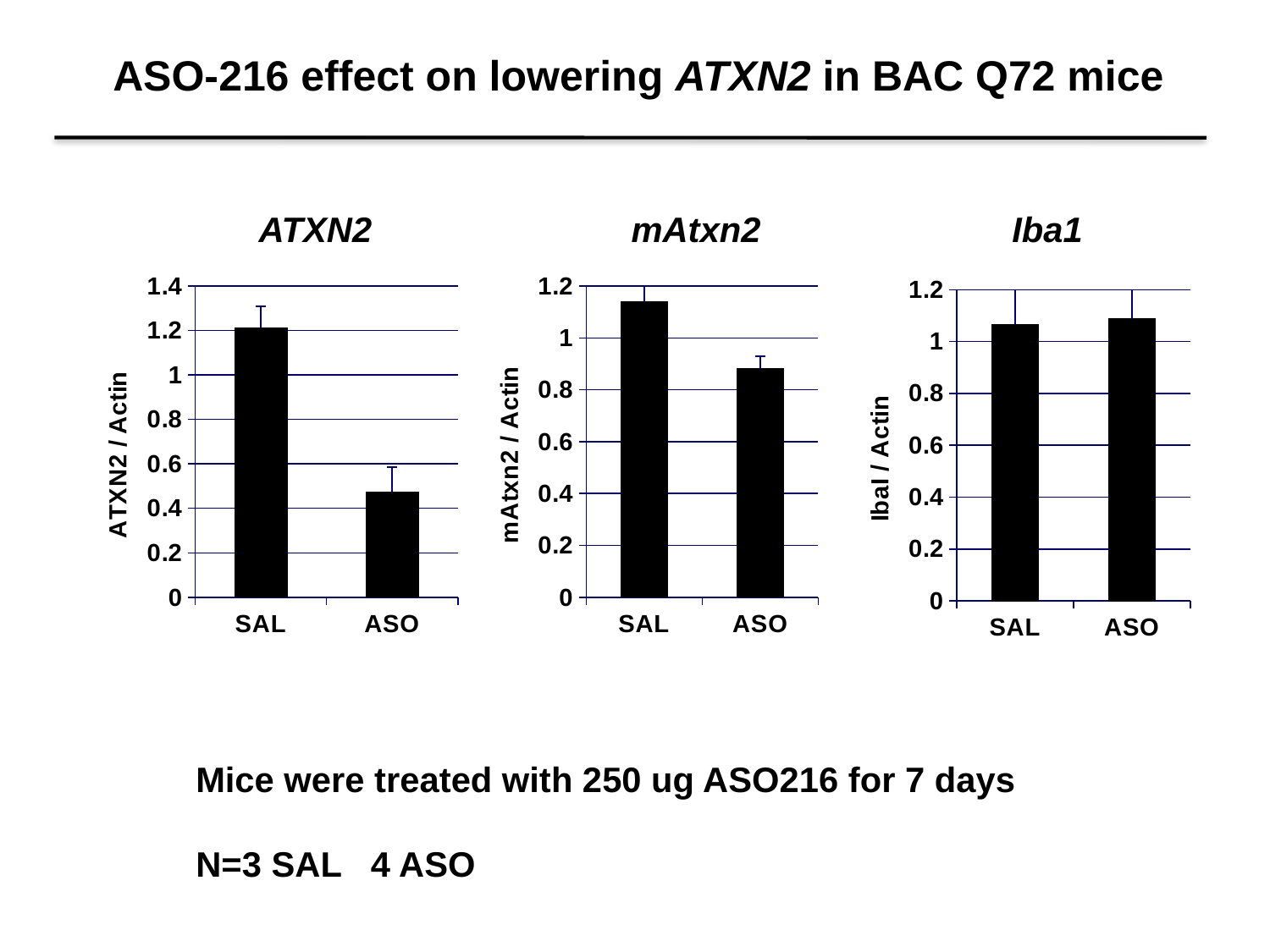
In the mAtxn2 chart, is the value for SAL greater or less than 1? greater In the ATXN2 chart, is the value for ASO greater or less than 0.6? less In the ATXN2 chart, is the value for SAL greater or less than 1? greater In the mAtxn2 chart, which category has the lowest bar? ASO How many categories are shown on the x axis of the ATXN2 chart? 2 What is the y-axis label of the Iba1 chart? Ibal / Actin What kind of chart is the mAtxn2 chart? bar chart In the ATXN2 chart, which category has the higher bar, SAL or ASO? SAL What is the title of the chart on the left of the slide? ATXN2